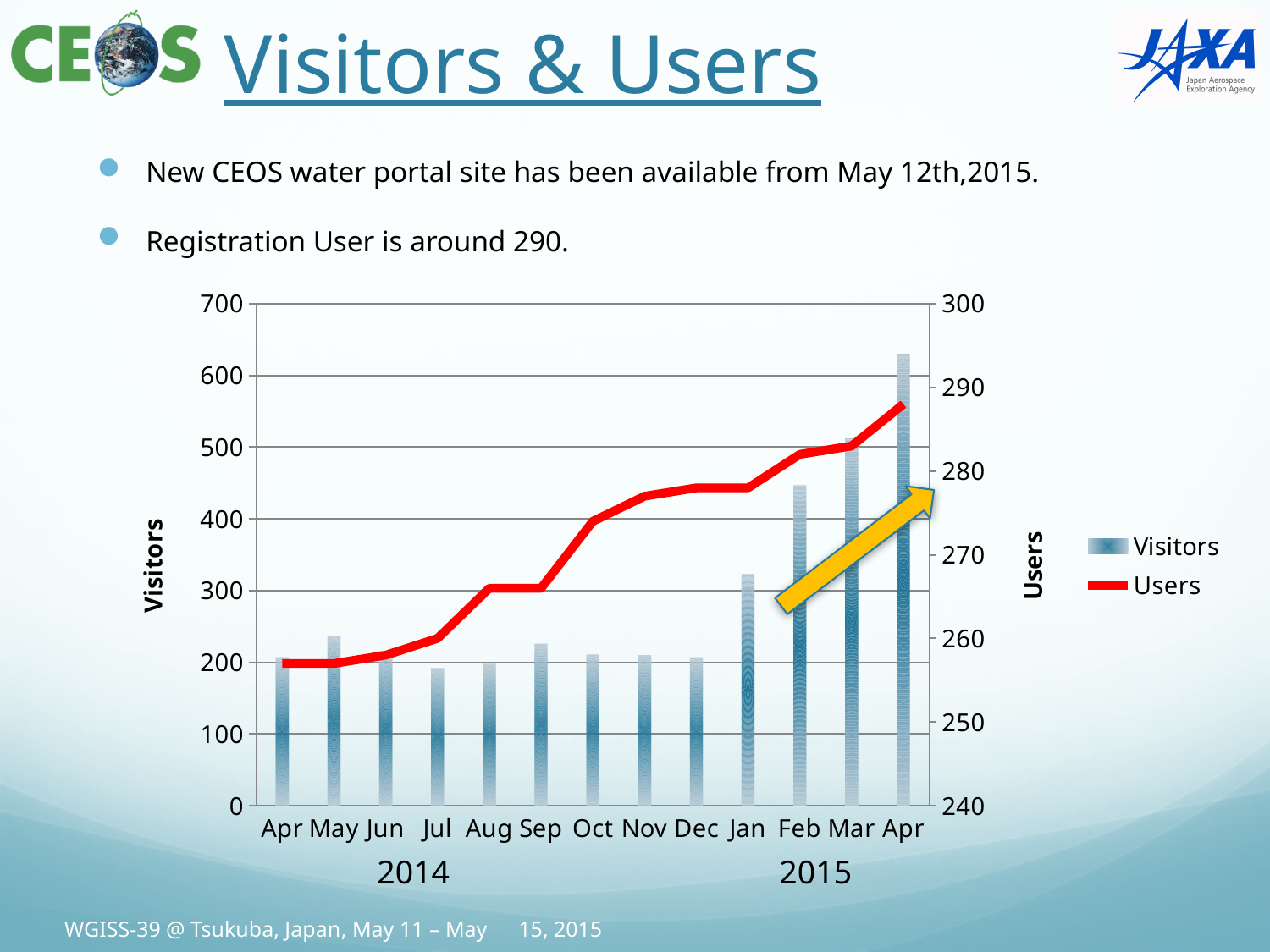
How many months are shown along the x axis of the chart? 13 Is the Users value for Apr 2015 greater or less than 280? greater Does the Users line rise or fall from Apr 2014 to Apr 2015? rise Which month has more Visitors, Feb 2015 or Mar 2015? Mar 2015 Is the Visitors value for Jan 2015 greater or less than 300? greater How many series does the chart's legend list? 2 Which series is drawn as a red line in the chart? Users Is the Visitors value for Apr 2015 greater or less than 600? greater What kind of chart is shown on the slide? A combined bar and line chart Which month has the highest number of Visitors? Apr 2015 What is the title of the left vertical axis? Visitors